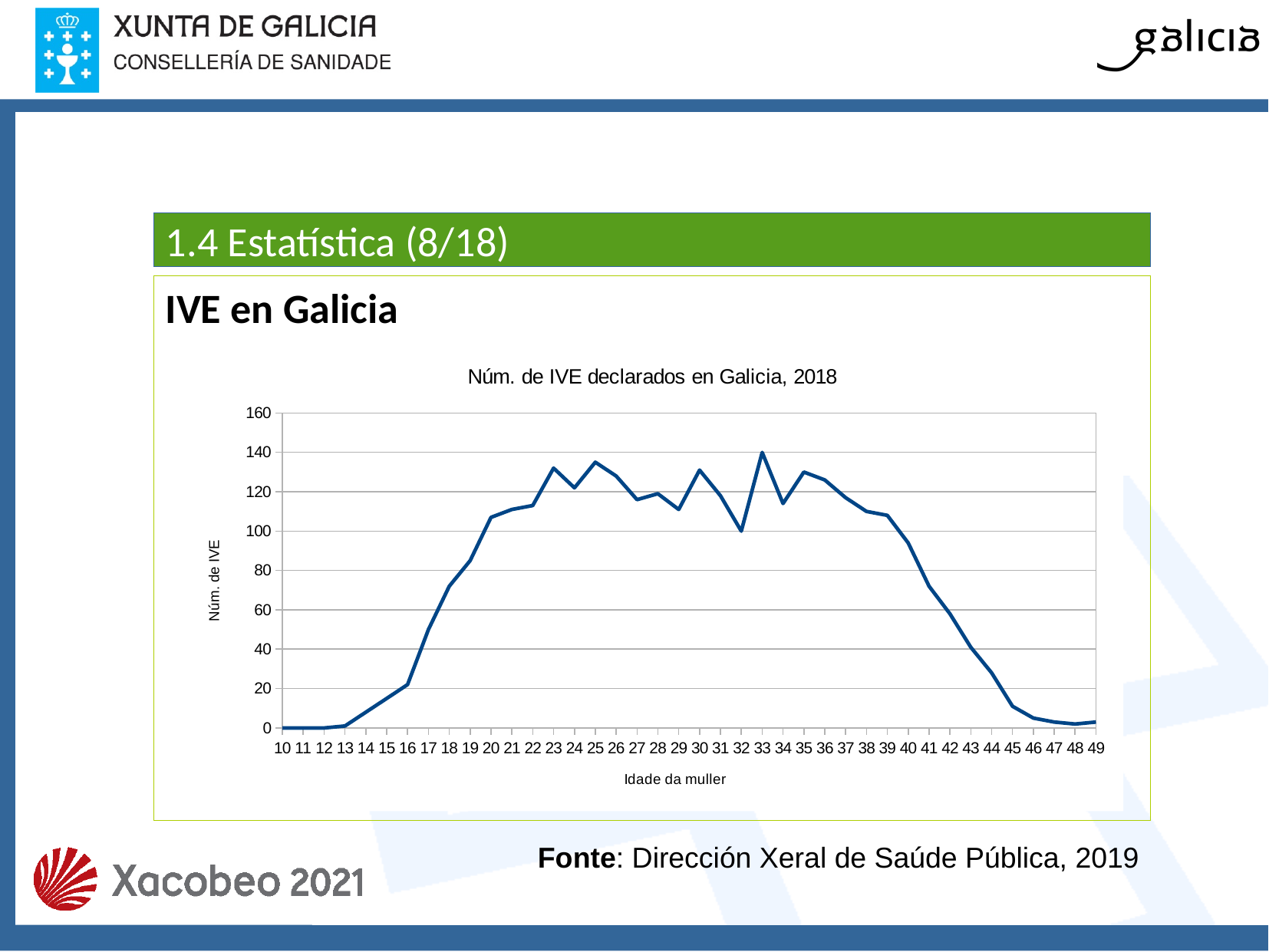
What is the number of IVE at age 10? 0 What is the label of the x axis of the chart? Idade da muller At which age does the number of IVE reach its highest value? 33 What kind of chart is shown on the slide? Line chart Is the value for age 16 greater or less than 40? less Is the value for age 38 greater or less than 100? greater What is the title of the chart? Núm. de IVE declarados en Galicia, 2018 Do the values rise or fall along the x axis from age 40 to age 49? fall Is the value for age 45 greater or less than 20? less How many ages are plotted along the x axis of the chart? 40 Which age has a higher number of IVE, 25 or 27? 25